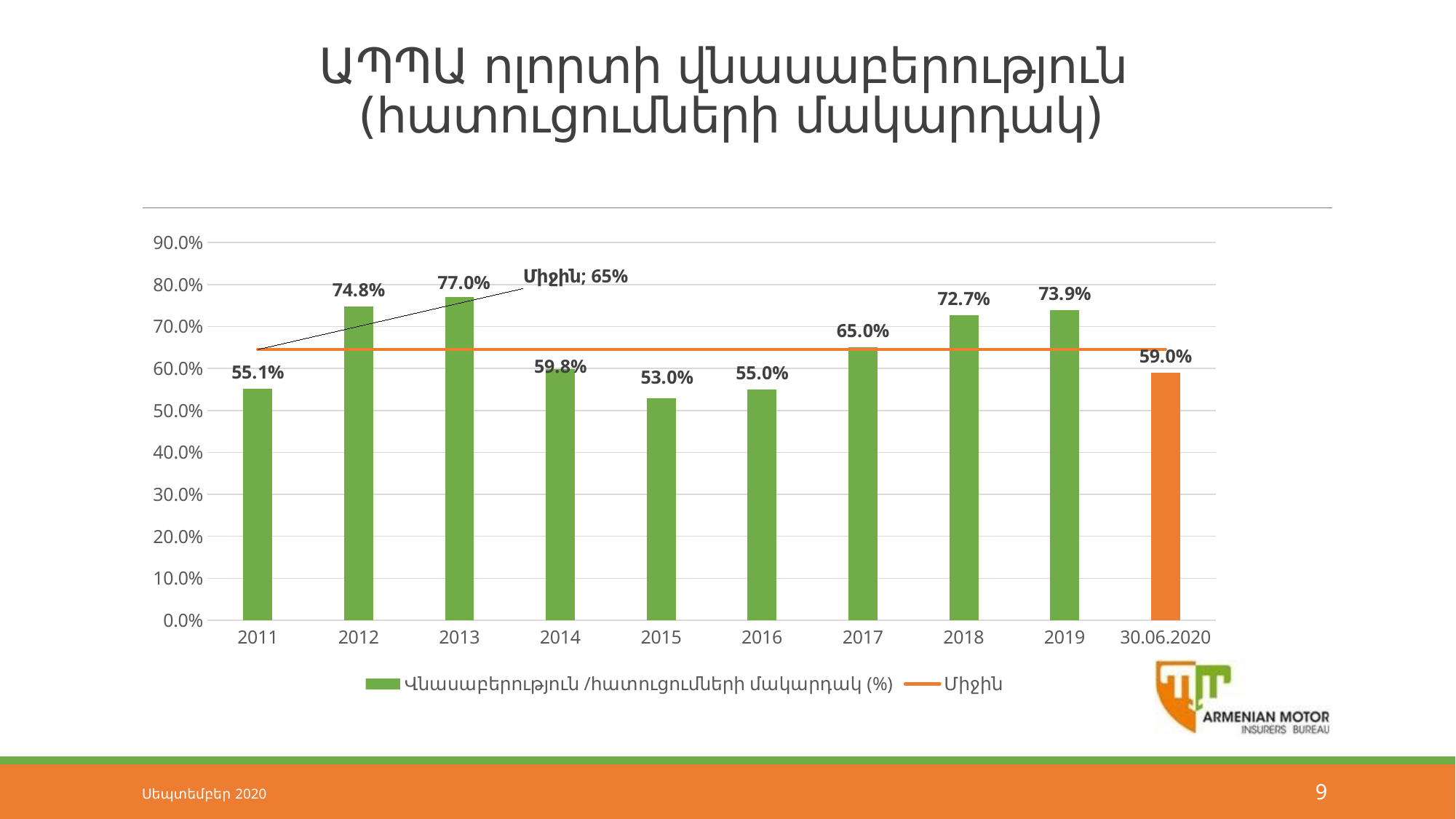
What kind of chart is shown on the slide? combination bar and line chart How many entries does the legend list? 2 What value is shown for the average (Միջին) line? 65% What is the value for 2013? 77.0% Which category has the lowest bar? 2015 Which year has the highest bar? 2013 What is the value for 30.06.2020? 59.0% What is the value for 2015? 53.0% What is the difference between the values for 2019 and 2018? 1.2% How many bars are shown in the chart? 10 Is the value for 2016 greater or less than 60.0%? less Which is larger, the value for 2012 or the value for 2014? 2012